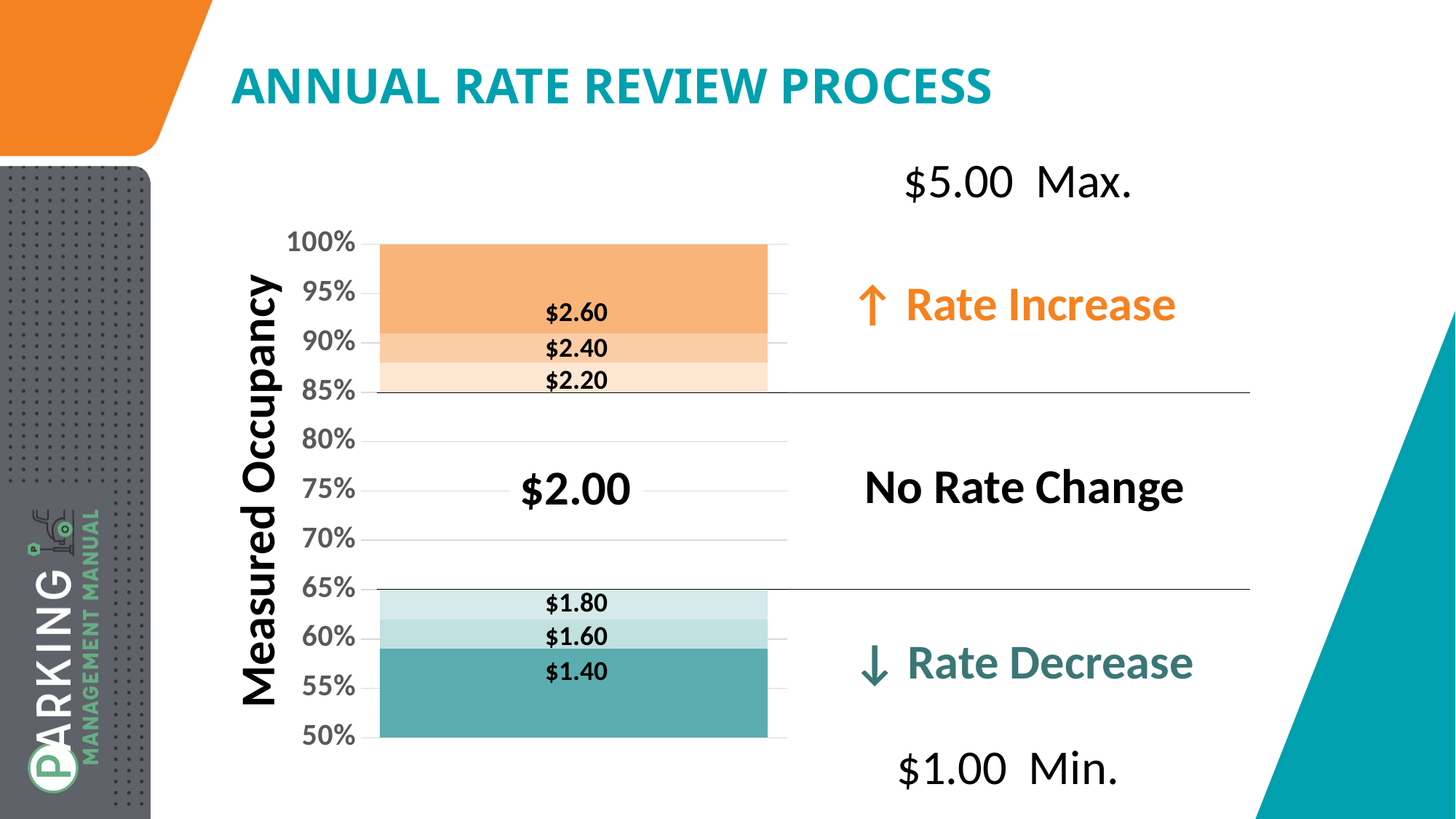
What is the label on the vertical axis of the chart? Measured Occupancy Which rate label printed inside the chart bands is the lowest? $1.40 What is the difference between the highest band rate ($2.60) and the lowest band rate ($1.40) in the chart? $1.20 What rate is shown for the 'No Rate Change' zone in the middle of the chart? $2.00 Which rate label printed inside the chart bands is the highest? $2.60 What is the title of the slide containing the chart? ANNUAL RATE REVIEW PROCESS What is the maximum rate stated above the chart? $5.00 What rate is printed in the bottom band of the chart, just above 50% occupancy? $1.40 What rate is printed in the topmost band of the chart, just below 100% occupancy? $2.60 What is the minimum rate stated below the chart? $1.00 How many distinct rate values are printed on the chart, including the $2.00 no-change rate? 7 What kind of chart is shown on the slide? Bar chart